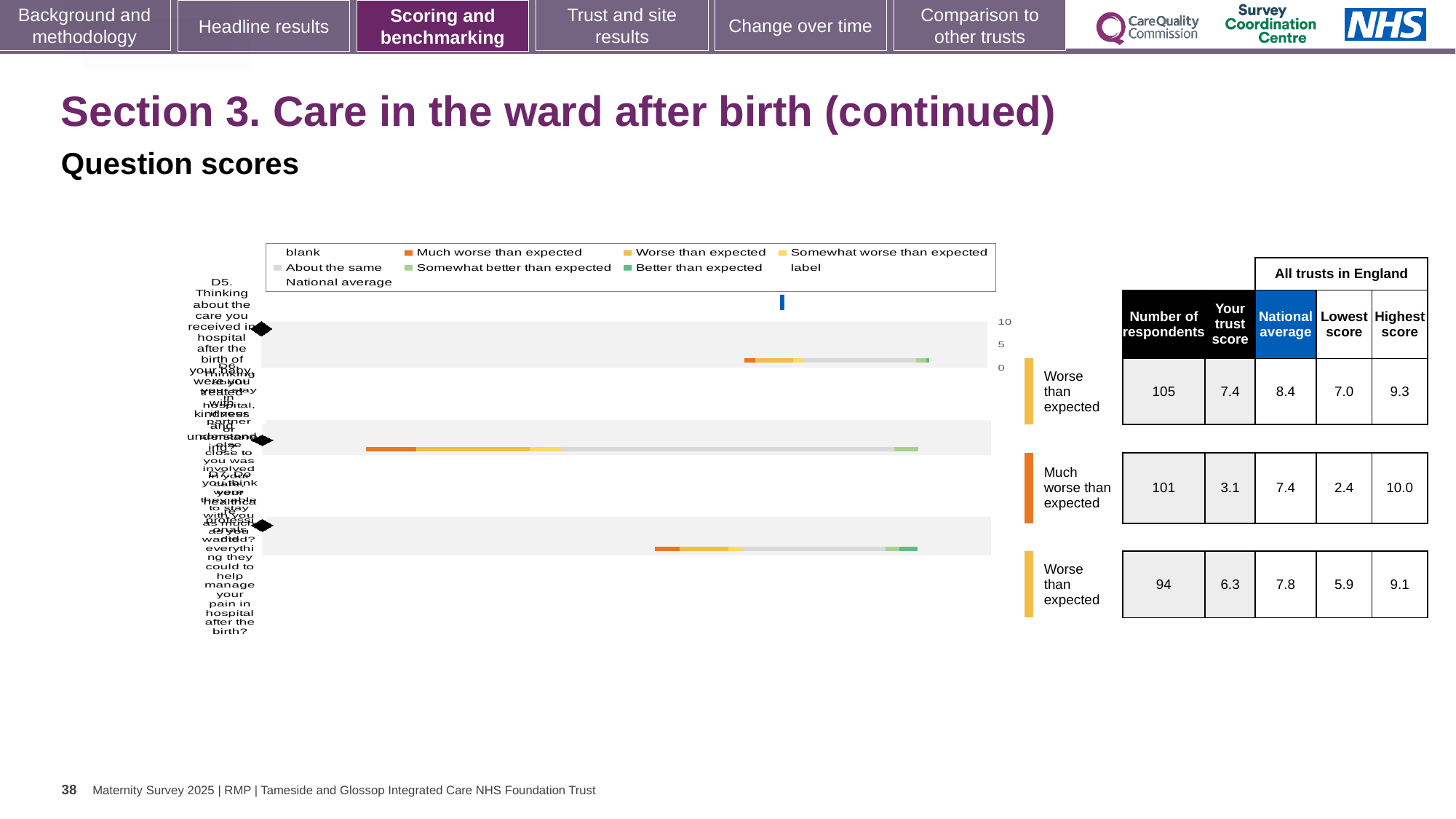
In the table beside the chart, what is the national average for the third question row? 7.8 How many entries does the chart legend list? 9 What is the difference between the highest and lowest scores in England for the third question row? 3.2 In the table beside the chart, what is the highest score in England for the second question row? 10.0 Is the trust score for the first question row larger or smaller than its national average? smaller In the table beside the chart, what is the number of respondents for the first question row? 105 What is the difference between the national average and the trust score for the second question row? 4.3 How many question bars are plotted in the chart? 3 What kind of chart is shown on the slide? bar chart What is the highest tick value shown on the chart's axis? 10 In the table beside the chart, what is the trust score for the second question row (rated 'Much worse than expected')? 3.1 Which question row has the lowest trust score in the table beside the chart? the second row (Much worse than expected)